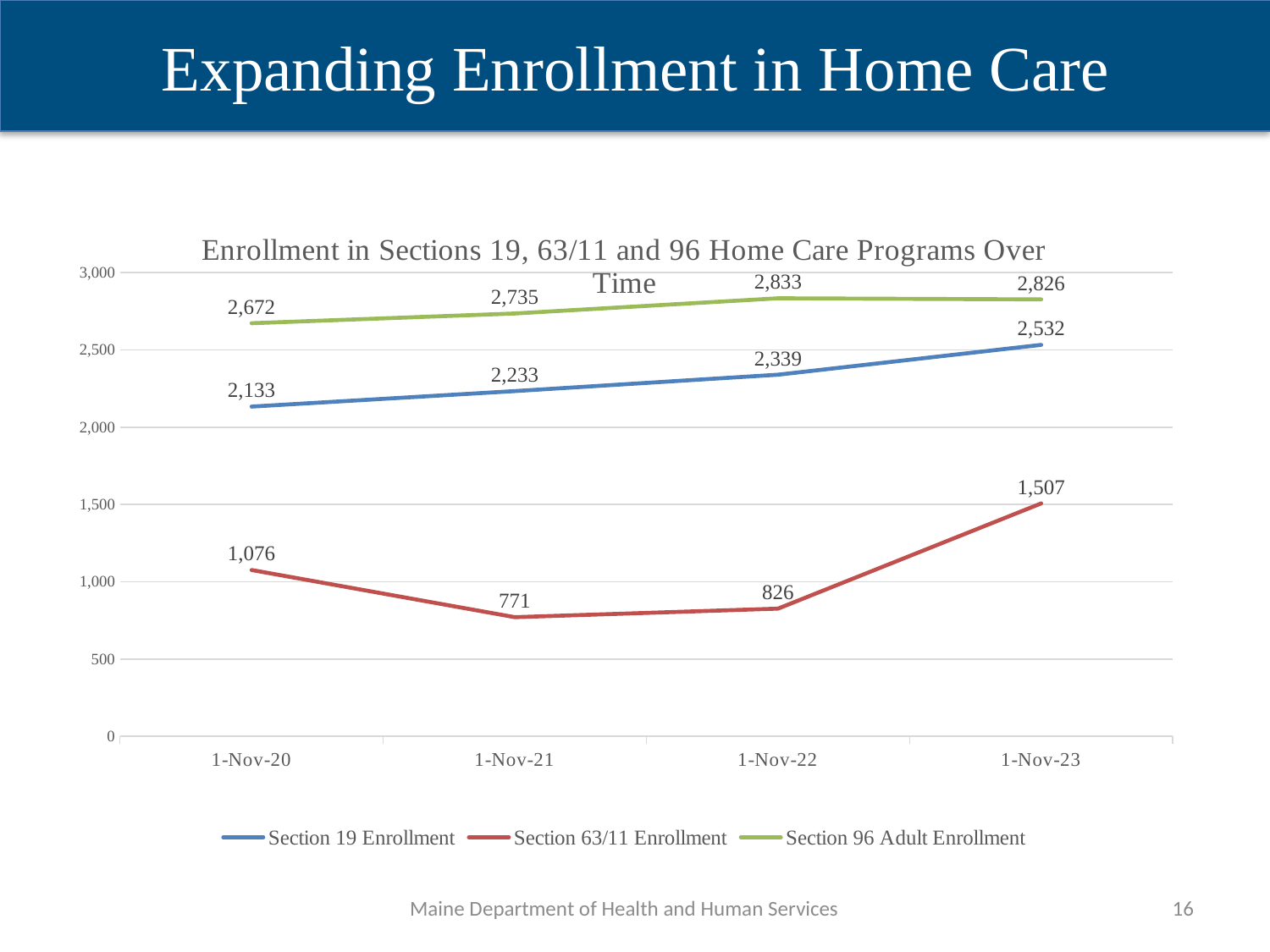
How many dates are shown on the x axis? 4 What is the Section 96 Adult Enrollment value on 1-Nov-23? 2,826 What is the difference between Section 19 Enrollment on 1-Nov-23 and on 1-Nov-20? 399 On which date is Section 96 Adult Enrollment highest? 1-Nov-22 How many series does the legend list? 3 On which date is Section 63/11 Enrollment lowest? 1-Nov-21 What is the Section 19 Enrollment value on 1-Nov-22? 2,339 What kind of chart is shown on the slide? Line chart Which is larger on 1-Nov-20: Section 19 Enrollment or Section 63/11 Enrollment? Section 19 Enrollment What is the difference between Section 63/11 Enrollment on 1-Nov-23 and on 1-Nov-22? 681 Does Section 19 Enrollment rise or fall from 1-Nov-20 to 1-Nov-23? Rise What is the Section 63/11 Enrollment value on 1-Nov-21? 771